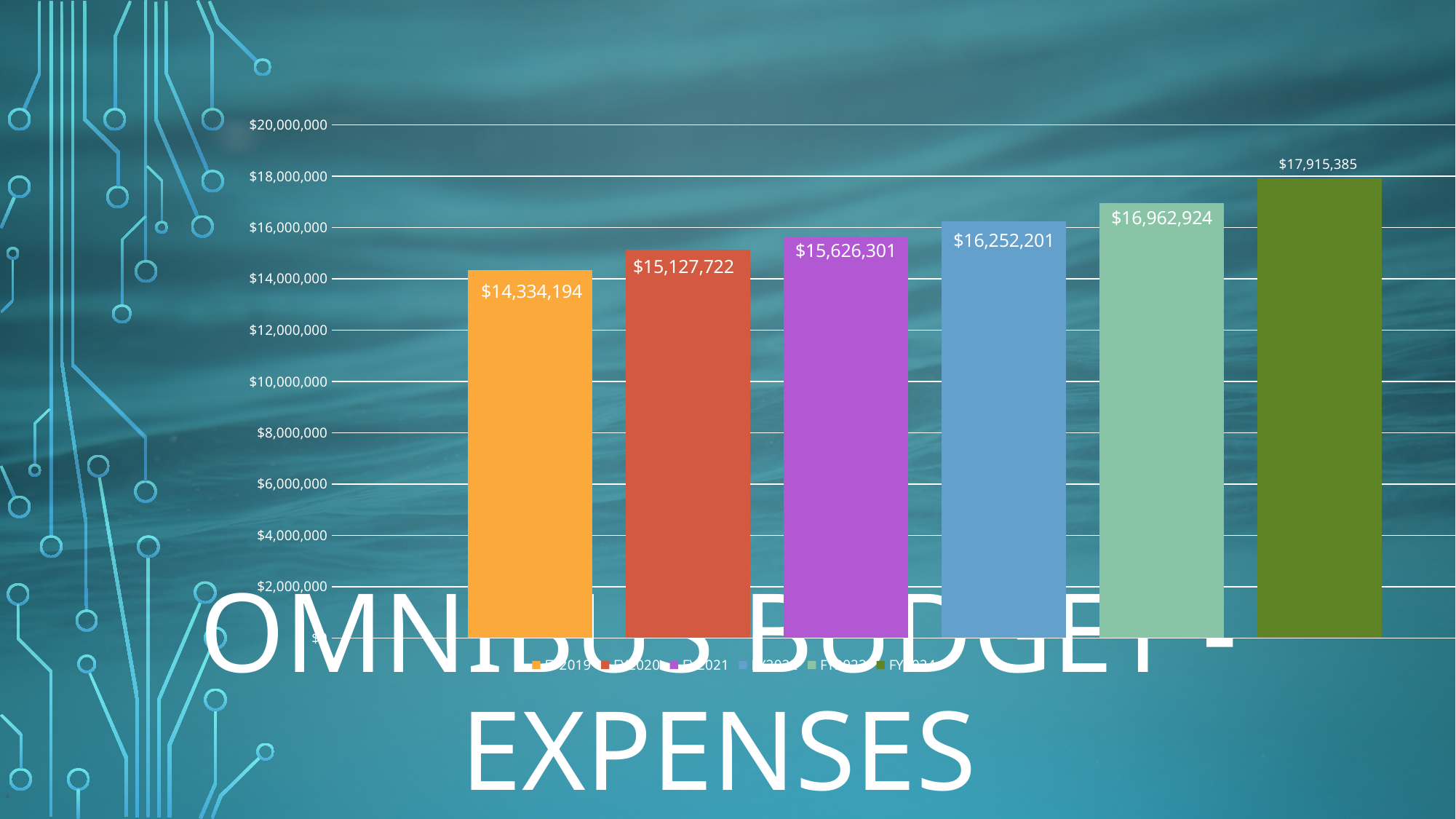
What is the difference between the last (dark green) bar and the first (orange) bar? $3,581,191 What is the value shown on the purple bar? $15,626,301 Do the values rise or fall from left to right across the bars? rise What is the value shown on the last (dark green) bar of the chart? $17,915,385 What is the value shown on the blue bar? $16,252,201 How many bars are plotted in the chart? 6 What is the value shown on the first (orange) bar of the chart? $14,334,194 Which bar has the lowest value? The first (orange) bar, $14,334,194 Is the value of the light green bar greater or less than $16,000,000? greater What is the difference between the dark green bar and the light green bar? $952,461 Which is larger, the blue bar or the purple bar? The blue bar ($16,252,201) Which bar has the highest value? The last (dark green) bar, $17,915,385